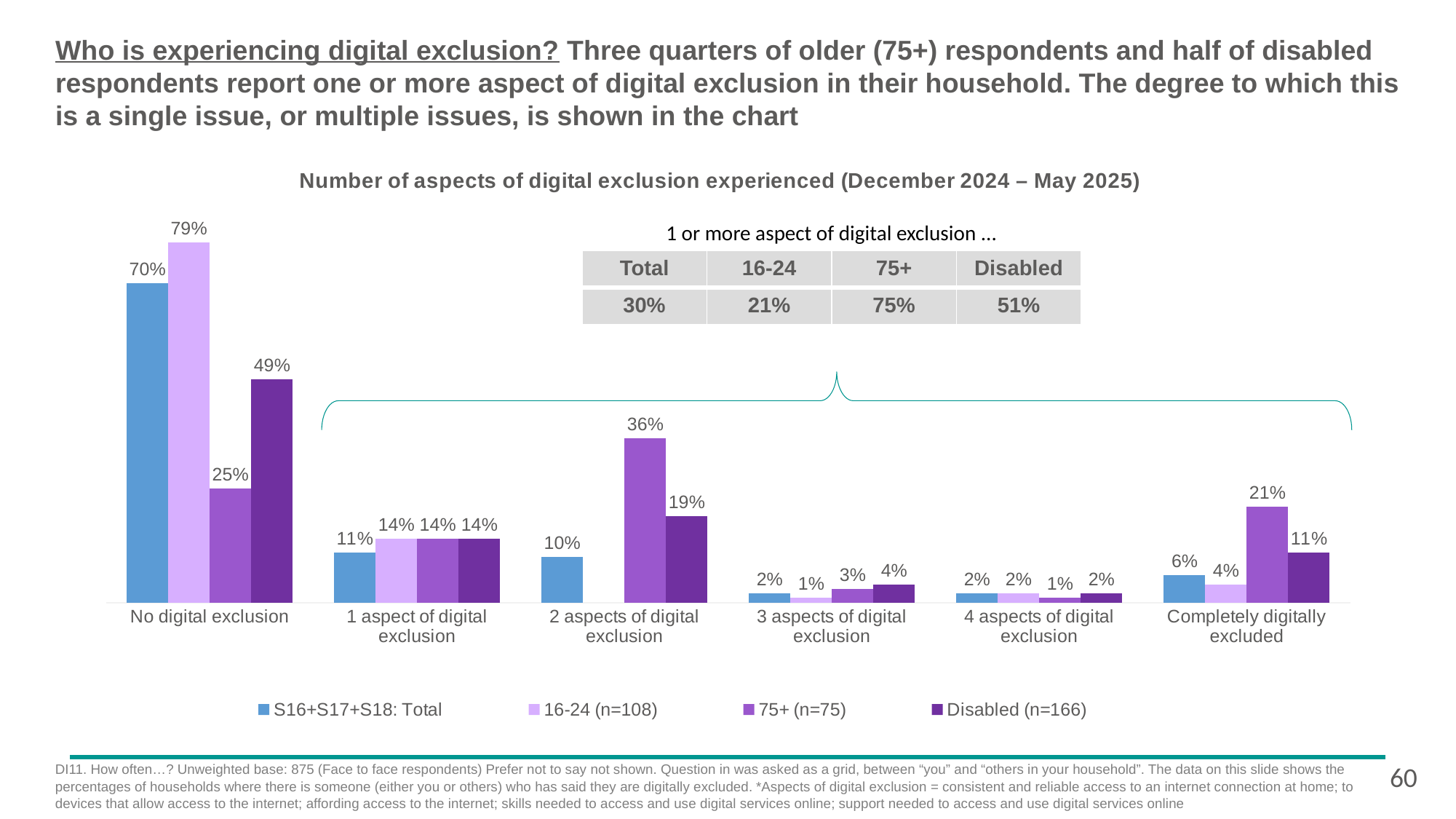
Which series has the lowest value in the 'No digital exclusion' category? 75+ (n=75) What is the difference between the 16-24 (n=108) and 75+ (n=75) values in the 'No digital exclusion' category? 54% What is the value for the 16-24 (n=108) series in the 'No digital exclusion' category? 79% How many categories are shown on the x axis of the chart? 6 What is the value for the 75+ (n=75) series in the 'No digital exclusion' category? 25% What is the value for the Disabled (n=166) series in the 'Completely digitally excluded' category? 11% In the '2 aspects of digital exclusion' category, which is larger: the 75+ (n=75) value or the Disabled (n=166) value? 75+ (n=75) Which series has the highest value in the 'Completely digitally excluded' category? 75+ (n=75) According to the table on the slide, what percentage of 75+ respondents report 1 or more aspect of digital exclusion? 75% What is the value for the 75+ (n=75) series in the '2 aspects of digital exclusion' category? 36% How many series does the chart legend list? 4 What type of chart is shown on the slide? Bar chart